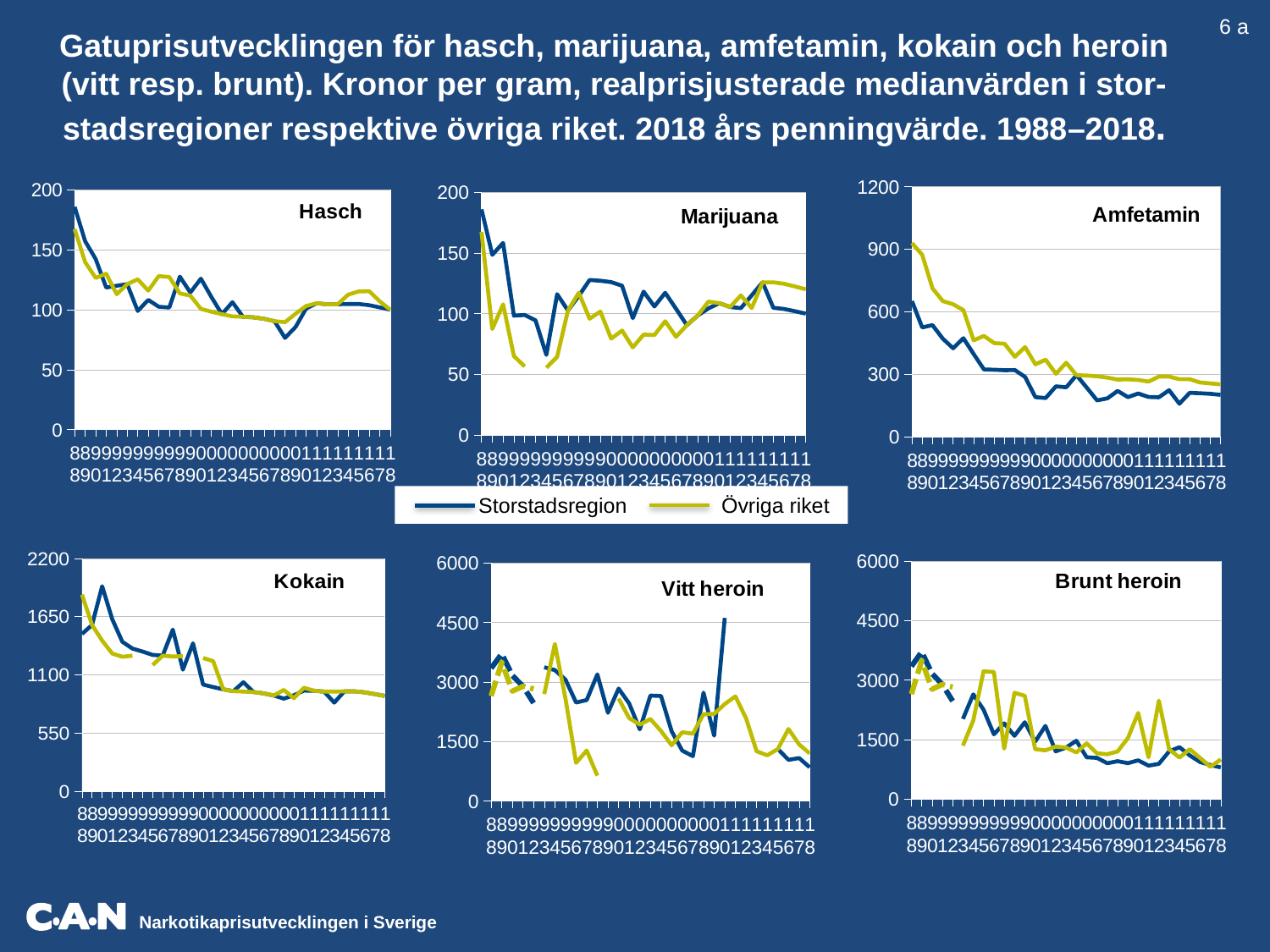
In the Amfetamin chart, do the values generally rise or fall from 1988 to 2018? fall How many charts are on the slide? 6 Which series is drawn in blue? Storstadsregion What are the two series named in the legend? Storstadsregion and Övriga riket In the Vitt heroin chart, is the Övriga riket value in 2018 greater or less than 1500? less In the Hasch chart, is the Storstadsregion value in 1988 greater or less than 150? greater How many series does the legend list? 2 In the Brunt heroin chart, is the Storstadsregion value in 2018 greater or less than 1500? less In the Kokain chart, which series has the higher value in 1988, Storstadsregion or Övriga riket? Övriga riket What kind of charts are shown on the slide? Line charts